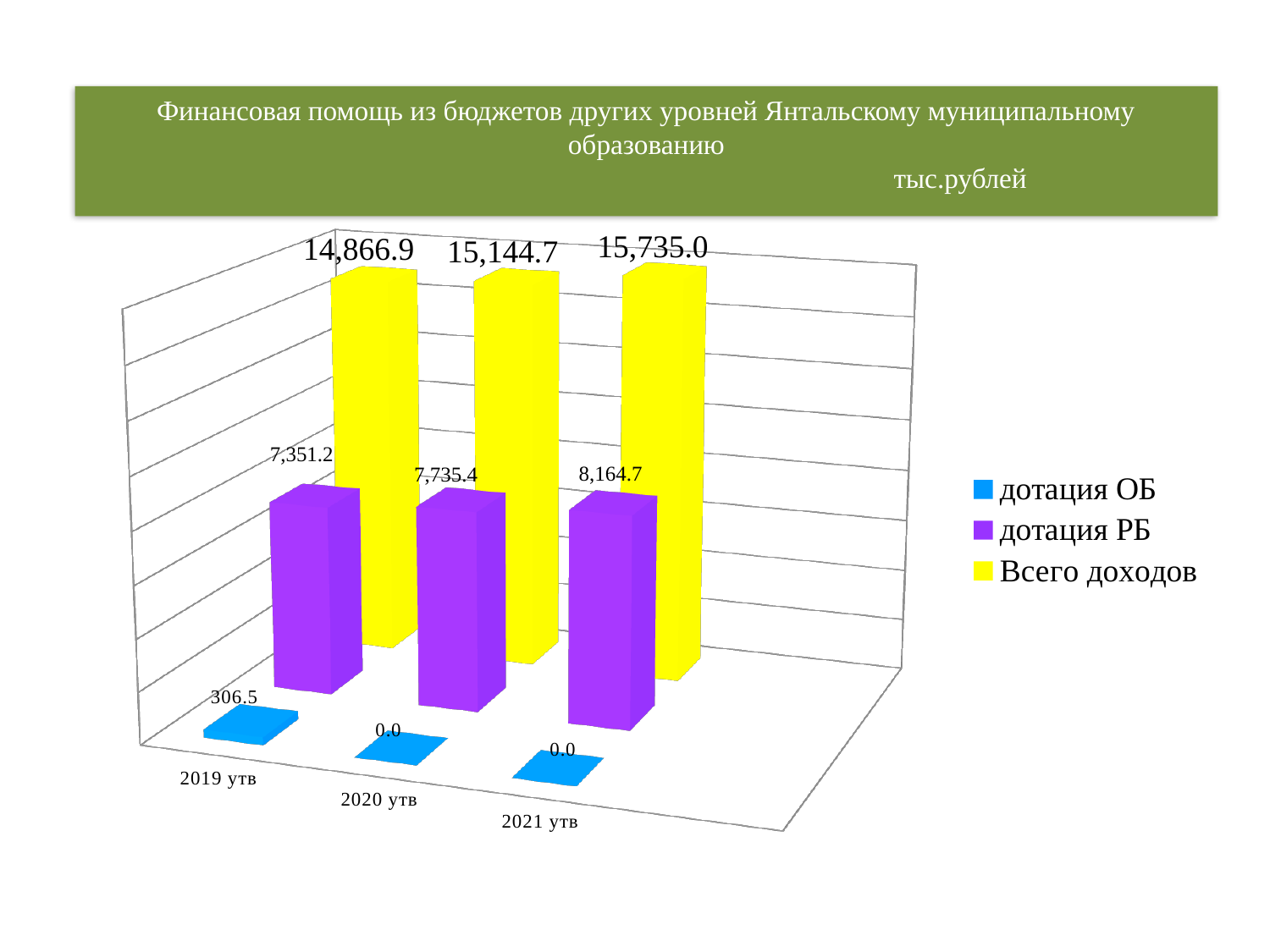
What is the value of дотация РБ for 2019 утв? 7,351.2 Does Всего доходов rise or fall from 2019 утв to 2021 утв? rise Which is larger: дотация РБ in 2021 утв or дотация РБ in 2020 утв? дотация РБ in 2021 утв How many series does the legend list? 3 How many years (categories) are shown on the x axis? 3 What is the difference between Всего доходов in 2021 утв and 2019 утв? 868.1 In which year is дотация РБ the lowest? 2019 утв What is the value of Всего доходов for 2021 утв? 15,735.0 What is the value of дотация ОБ for 2020 утв? 0.0 What is the value of дотация ОБ for 2019 утв? 306.5 In which year is Всего доходов the highest? 2021 утв What is the difference between дотация РБ in 2020 утв and 2019 утв? 384.2